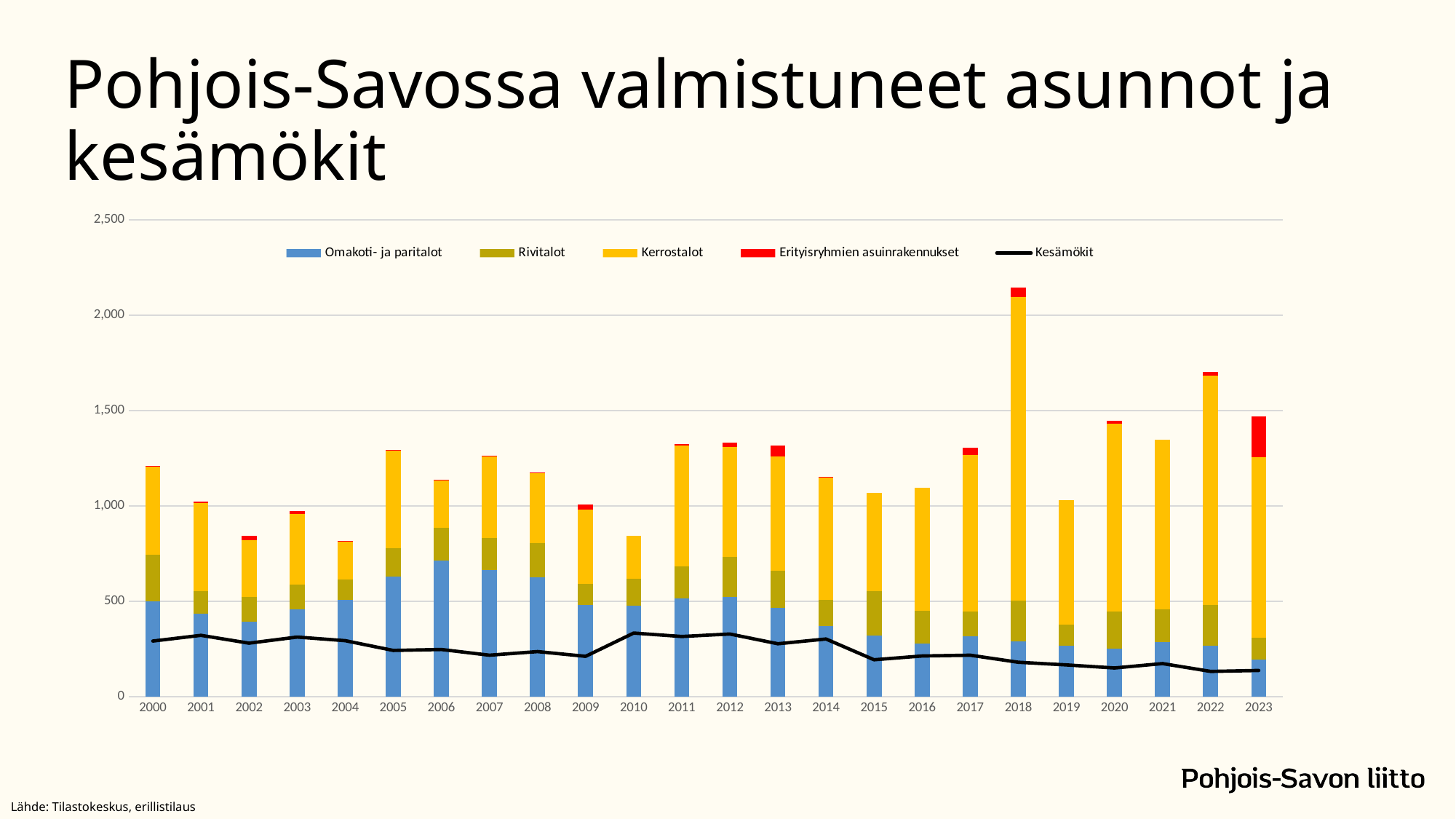
Does the Kesämökit line generally rise or fall from 2000 to 2023? fall Is the Kesämökit value for 2023 greater or less than 500? less What kind of chart is shown on the slide? Stacked bar chart with a line Which year has the larger Kesämökit value, 2001 or 2022? 2001 Is the Omakoti- ja paritalot segment for 2006 greater or less than 500? greater Is the total stacked bar for 2004 greater or less than 1,000? less Which year has the larger total stacked bar, 2018 or 2022? 2018 How many years are shown along the x axis of the chart? 24 Which year has the tallest stacked bar in the chart? 2018 What is the title of the chart on the slide? Pohjois-Savossa valmistuneet asunnot ja kesämökit How many series does the chart's legend list? 5